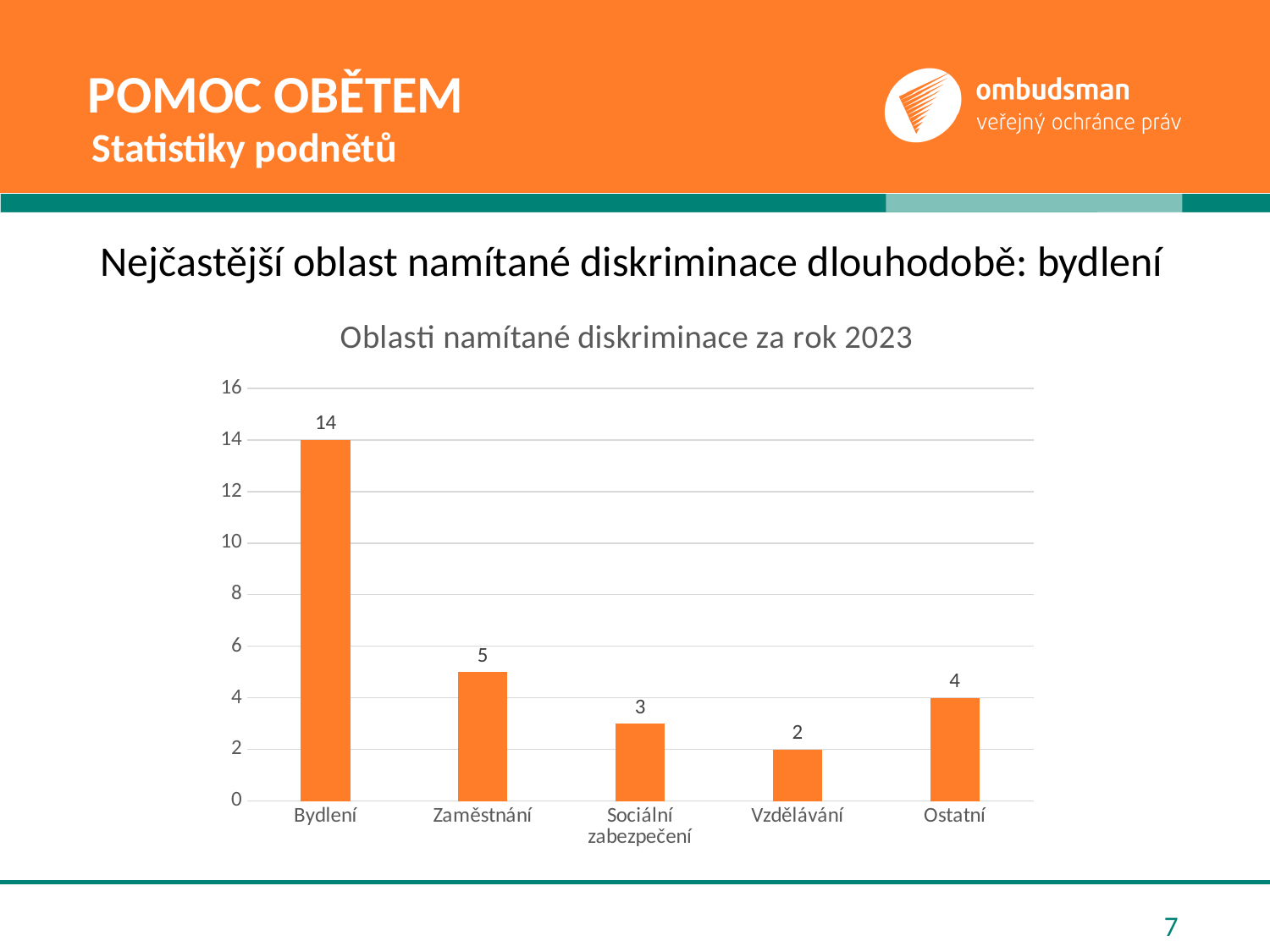
What is the difference between the values for Bydlení and Zaměstnání? 9 Which is larger, the value for Ostatní or the value for Sociální zabezpečení? Ostatní Which category has the lowest value? Vzdělávání What kind of chart is shown on the slide? Bar chart What is the value for Bydlení? 14 How many categories are shown on the x axis? 5 Which category has the highest value? Bydlení What is the value for Zaměstnání? 5 What is the value for Sociální zabezpečení? 3 What is the value for Vzdělávání? 2 What is the value for Ostatní? 4 What is the title of the chart? Oblasti namítané diskriminace za rok 2023